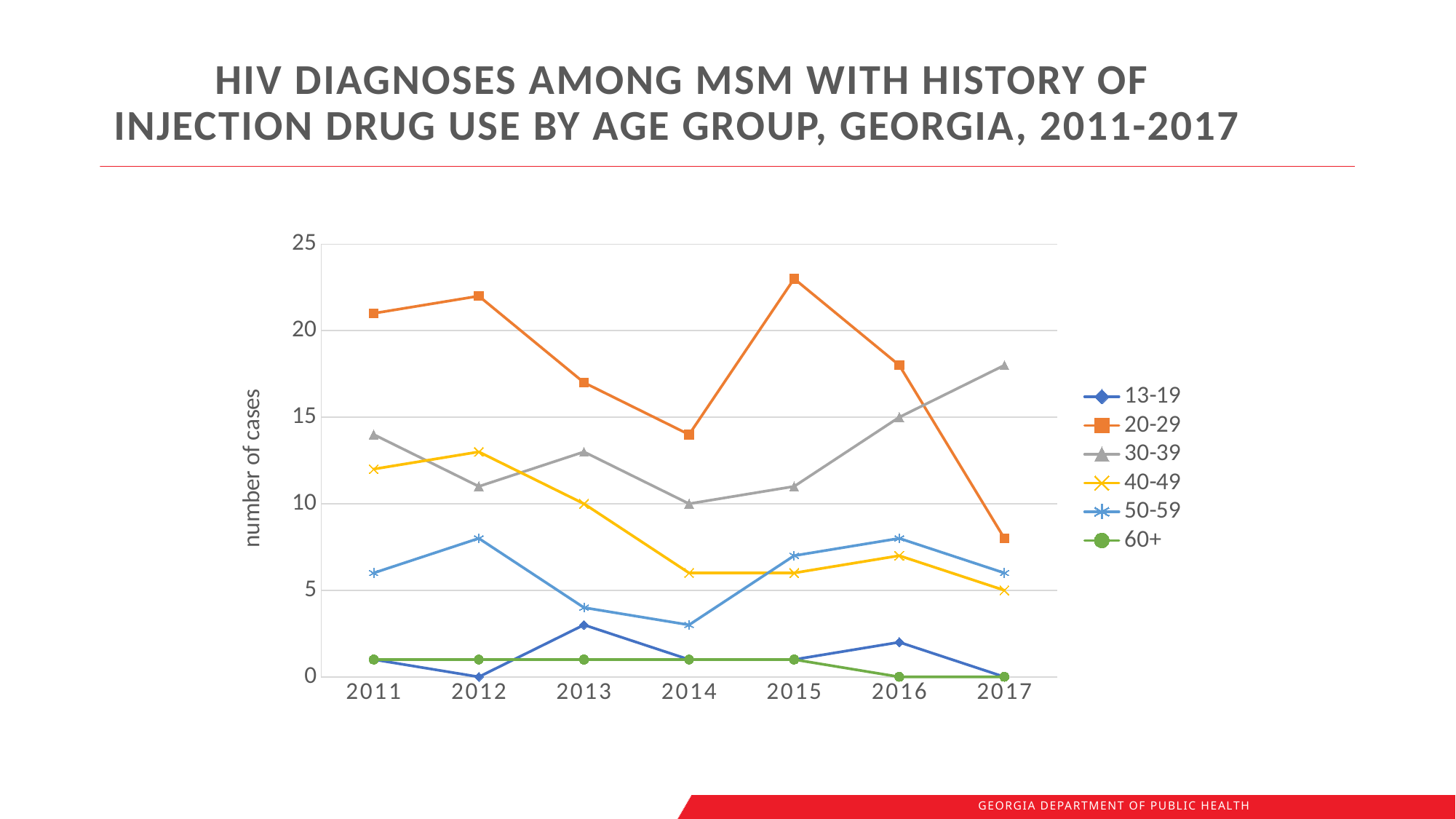
What is the number of cases for the 60+ age group in 2017? 0 What is the number of cases for the 40-49 age group in 2017? 5 Is the value for the 20-29 age group in 2011 greater or less than 20? greater What is the number of cases for the 30-39 age group in 2014? 10 What kind of chart is shown on the slide? line chart Which age group has the highest number of cases in 2017? 30-39 Does the 20-29 line rise or fall from 2015 to 2017? fall How many age groups does the legend list? 6 Is the value for the 50-59 age group in 2014 greater or less than 5? less How many years are shown on the x axis? 7 Which is larger in 2016, the value for 30-39 or the value for 20-29? 20-29 Which age group has the highest number of cases in 2015? 20-29